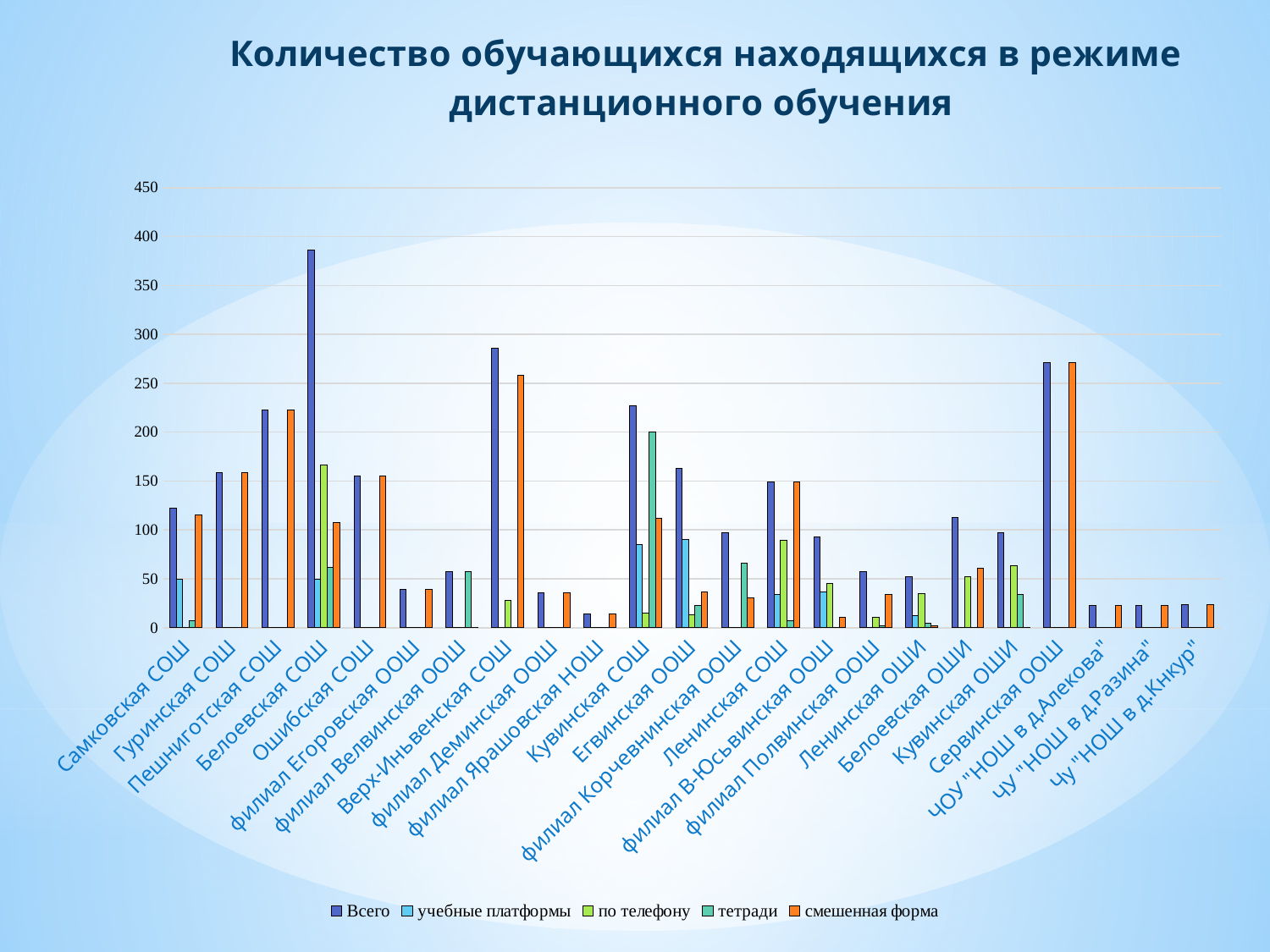
Which school has the lowest value for the series "Всего"? филиал Ярашовская НОШ How many schools (categories) are shown on the x axis? 23 Which is larger, the "Всего" value for Белоевская СОШ or for Верх-Иньвенская СОШ? Белоевская СОШ Is the "учебные платформы" value for Егвинская ООШ greater or less than 100? less How many series does the legend list? 5 Is the "Всего" value for Верх-Иньвенская СОШ greater or less than 250? greater Which school has the highest value for the series "Всего"? Белоевская СОШ Is the "Всего" value for Самковская СОШ greater or less than 100? greater What kind of chart is shown on the slide? bar chart What is the title of the chart? Количество обучающихся находящихся в режиме дистанционного обучения Which is larger, the "Всего" value for Кувинская СОШ or for Ленинская СОШ? Кувинская СОШ